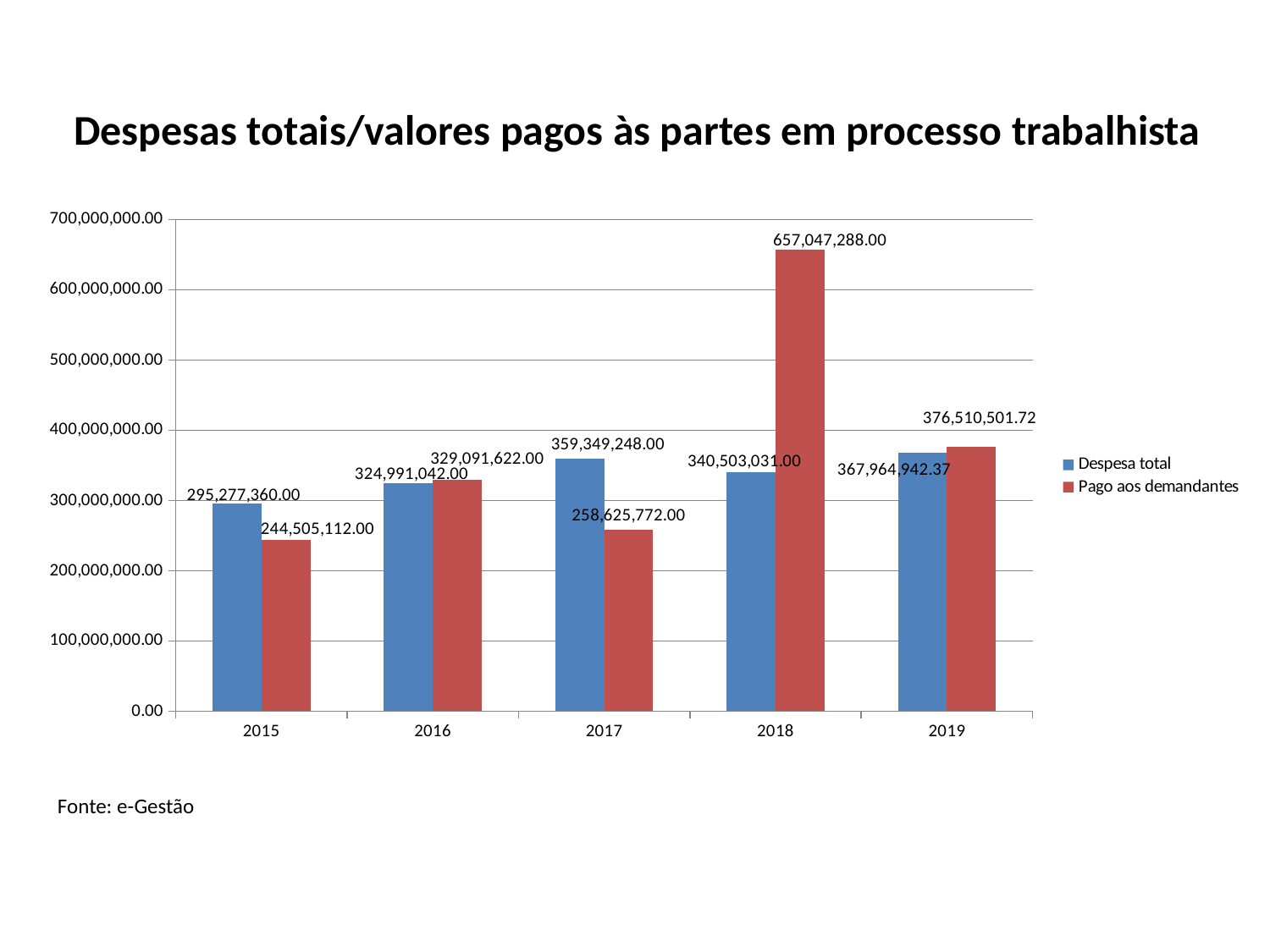
What is the value of Despesa total for 2019? 367,964,942.37 What kind of chart is shown on the slide? Bar chart How many years are shown on the x axis? 5 What is the difference between Pago aos demandantes and Despesa total in 2018? 316,544,257.00 What is the value of Despesa total for 2015? 295,277,360.00 In which year is Pago aos demandantes highest? 2018 What is the difference between Despesa total and Pago aos demandantes in 2017? 100,723,476.00 How many series does the legend list? 2 What is the value of Pago aos demandantes for 2017? 258,625,772.00 What is the value of Pago aos demandantes for 2018? 657,047,288.00 In which year is Pago aos demandantes lowest? 2015 In 2016, which is larger: Despesa total or Pago aos demandantes? Pago aos demandantes